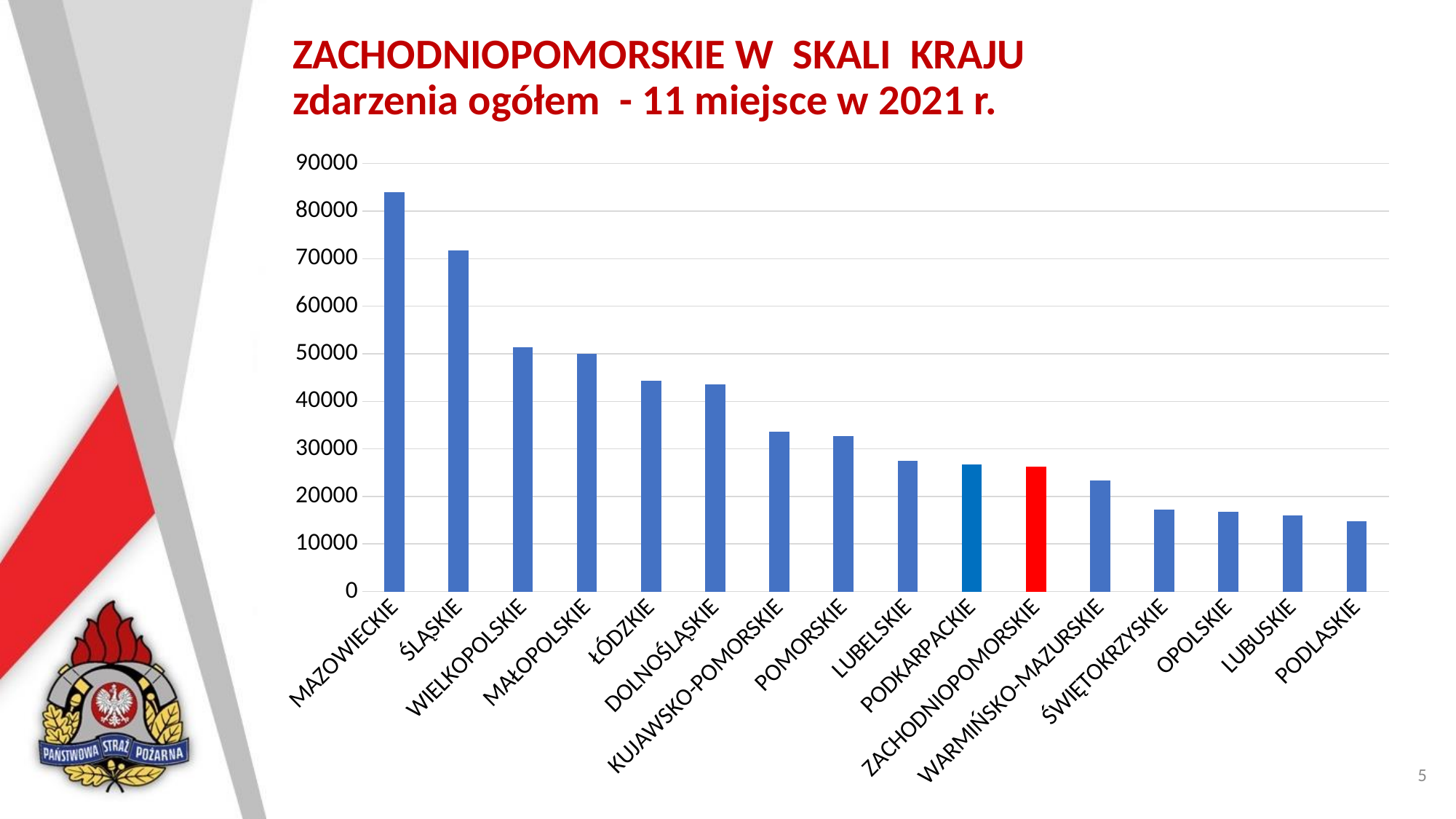
Do the values rise or fall moving from left to right along the x axis? fall Which voivodeship has the highest value? MAZOWIECKIE Is the value for MAZOWIECKIE greater or less than 80000? greater What kind of chart is shown on the slide? bar chart Which voivodeship's bar is coloured red? ZACHODNIOPOMORSKIE Is the value for PODLASKIE greater or less than 20000? less Which has a larger value, MAZOWIECKIE or ŚLĄSKIE? MAZOWIECKIE Is the value for ZACHODNIOPOMORSKIE greater or less than 20000? greater How many voivodeships (categories) are shown on the x axis? 16 Which voivodeship has the lowest value? PODLASKIE